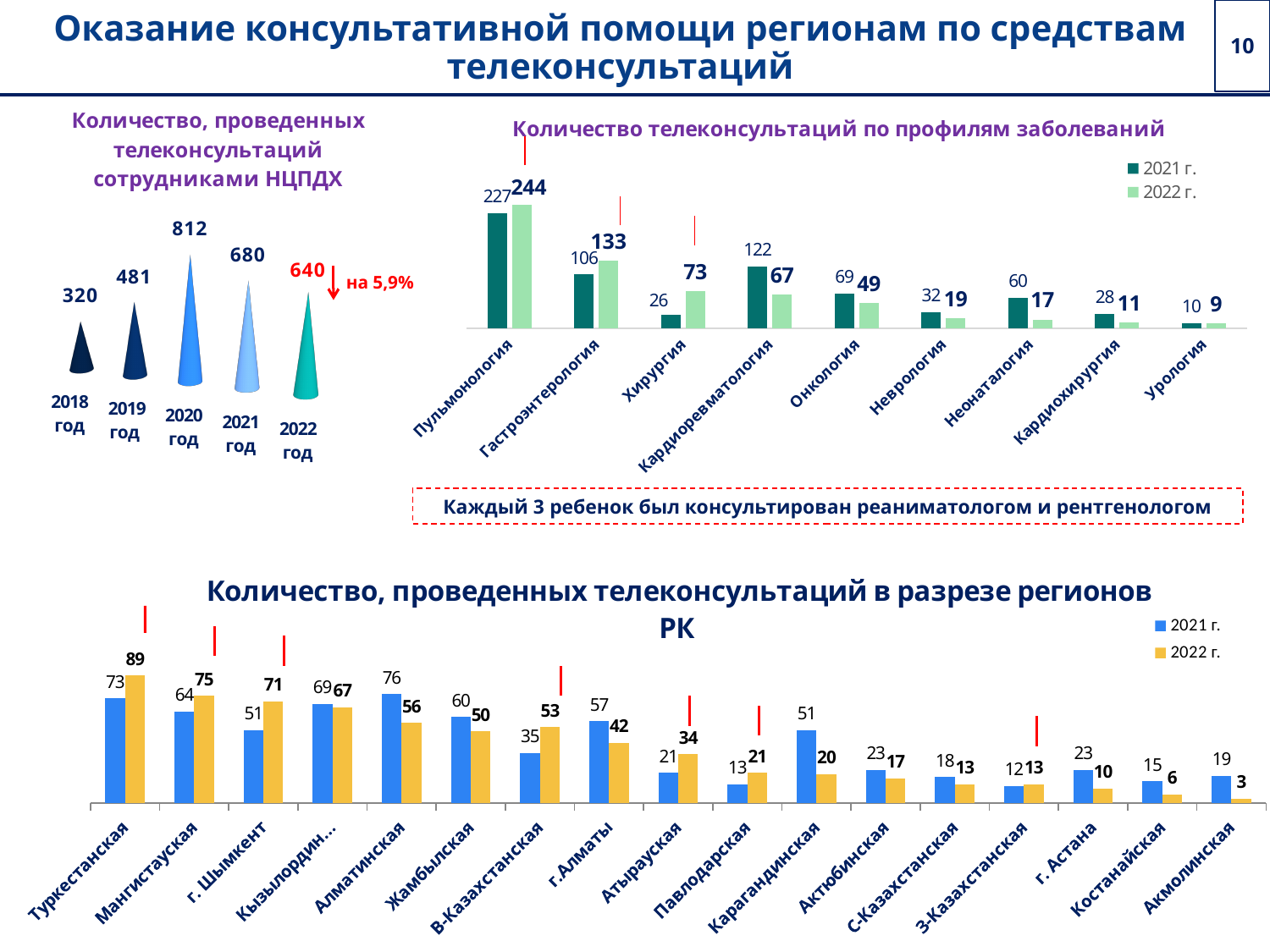
In the chart 'Количество, проведенных телеконсультаций в разрезе регионов РК', what is the difference between the 2021 г. and 2022 г. values for Карагандинская? 31 In the chart 'Количество телеконсультаций по профилям заболеваний', which is larger for Кардиоревматология: the 2021 г. value or the 2022 г. value? 2021 г. In the chart 'Количество, проведенных телеконсультаций в разрезе регионов РК', what is the 2022 г. value for Туркестанская? 89 In the chart 'Количество, проведенных телеконсультаций сотрудниками НЦПДХ', which year has the lowest value? 2018 год In the chart 'Количество телеконсультаций по профилям заболеваний', how many series does the legend list? 2 In the chart 'Количество, проведенных телеконсультаций сотрудниками НЦПДХ', what is the difference between the 2020 год and 2022 год values? 172 In the chart 'Количество, проведенных телеконсультаций в разрезе регионов РК', which region has the lowest 2022 г. value? Акмолинская In the chart 'Количество, проведенных телеконсультаций сотрудниками НЦПДХ', what is the value for 2020 год? 812 In the chart 'Количество телеконсультаций по профилям заболеваний', which profile has the highest 2021 г. value? Пульмонология In the chart 'Количество телеконсультаций по профилям заболеваний', how many disease profiles are shown on the x axis? 9 What type of chart is 'Количество, проведенных телеконсультаций в разрезе регионов РК'? Bar chart In the chart 'Количество телеконсультаций по профилям заболеваний', what is the 2022 г. value for Хирургия? 73